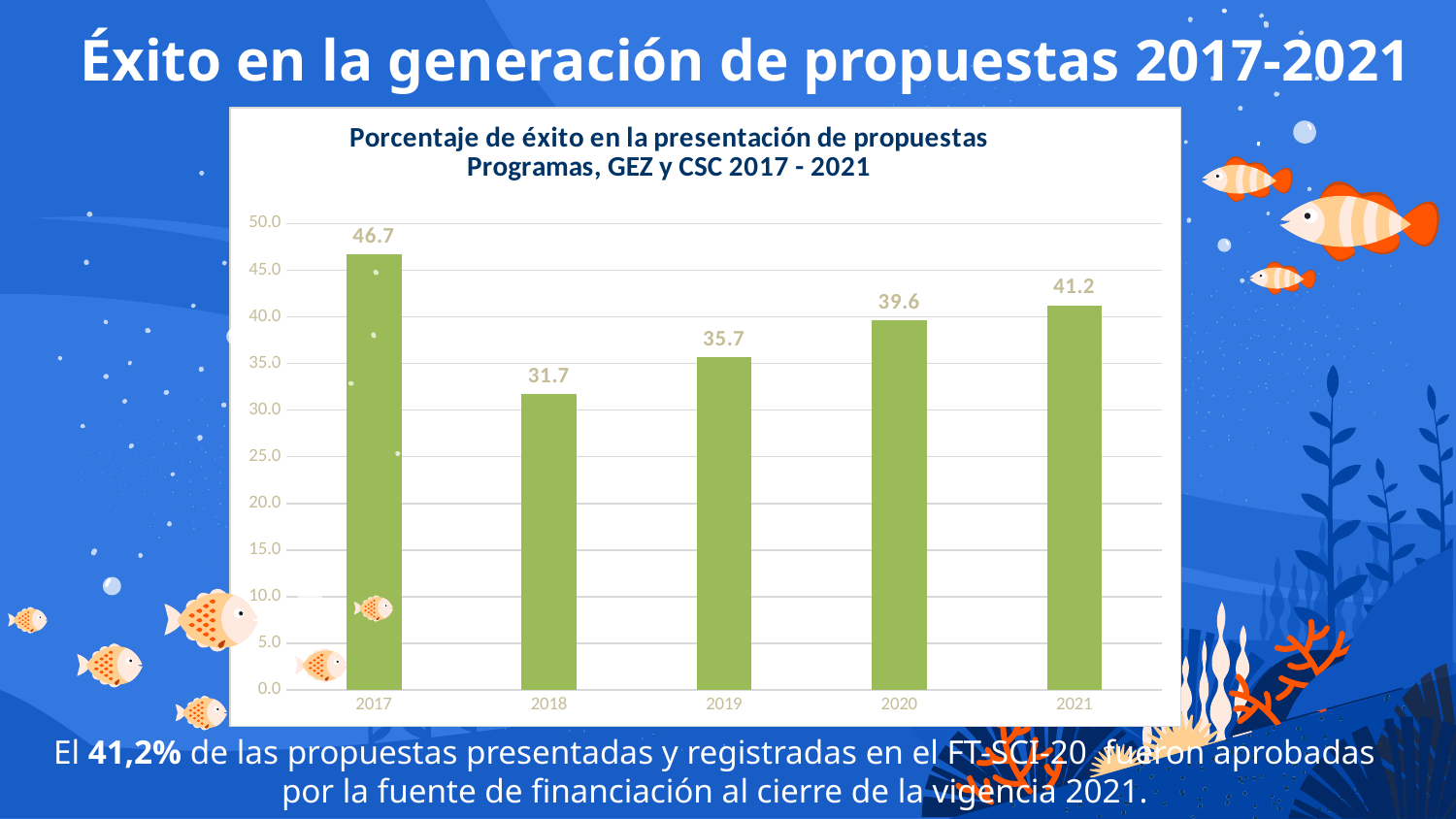
What kind of chart is shown? bar chart What is the difference between the values for 2017 and 2018? 15.0 What is the difference between the values for 2021 and 2020? 1.6 Which is larger, the value for 2019 or the value for 2021? 2021 Do the values rise or fall from 2018 to 2021? rise How many years are shown on the x axis? 5 Which year has the highest value? 2017 Is the value for 2019 greater or less than 40.0? less What is the value for 2018? 31.7 Which year has the lowest value? 2018 What is the value for 2020? 39.6 What is the value for 2017? 46.7